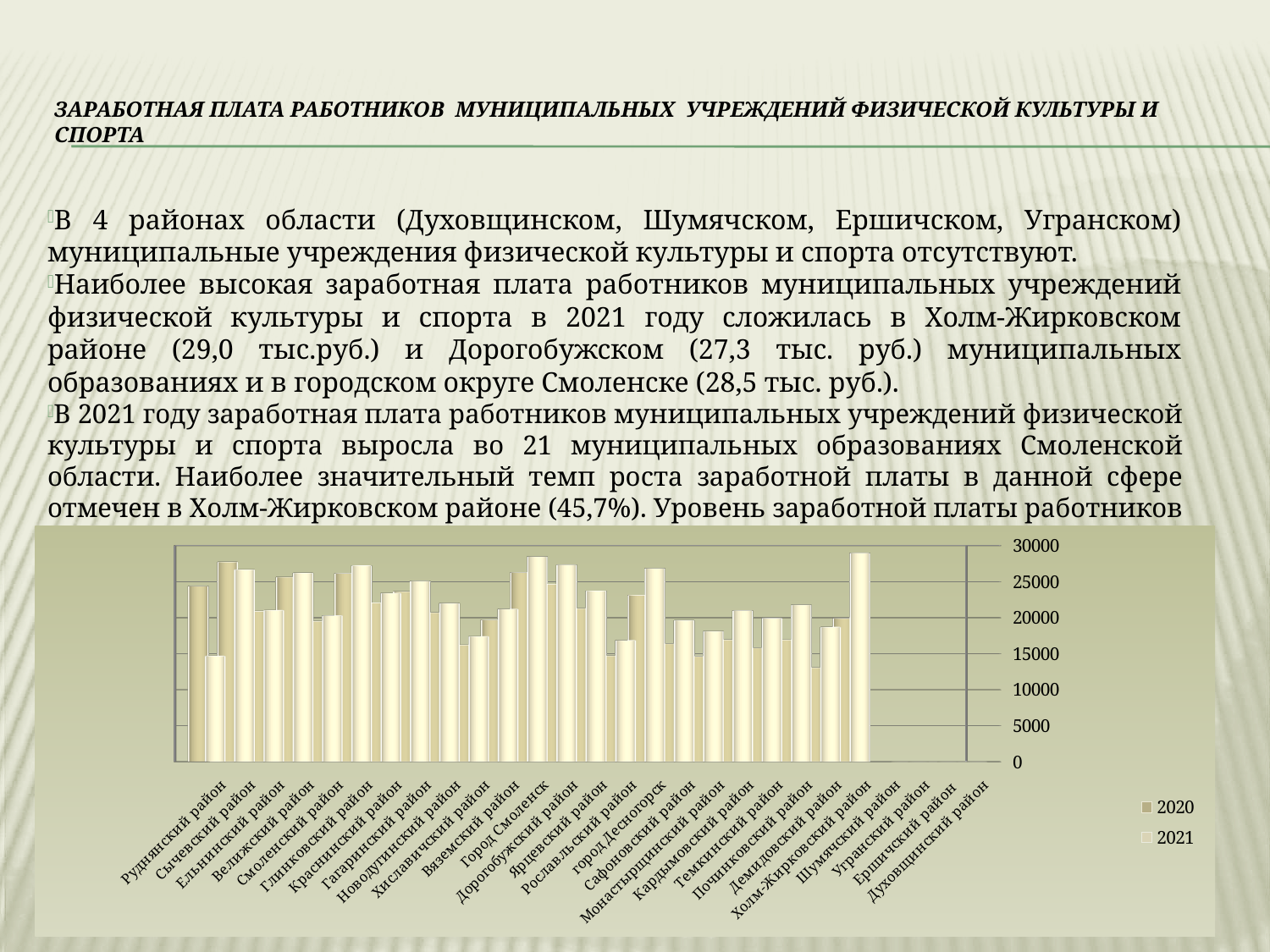
Is the 2021 value for Холм-Жирковский район greater or less than 25000? greater For Холм-Жирковский район, which is larger: the 2020 value or the 2021 value? 2021 Is the 2020 value for Холм-Жирковский район greater or less than 25000? less What kind of chart is shown on the slide? bar chart How many categories (districts) are listed along the x axis of the chart? 27 Is the 2020 value for Сычевский район greater or less than 25000? greater Which years are listed in the chart legend? 2020 and 2021 How many series does the chart legend list? 2 What is the highest value shown on the chart's vertical axis? 30000